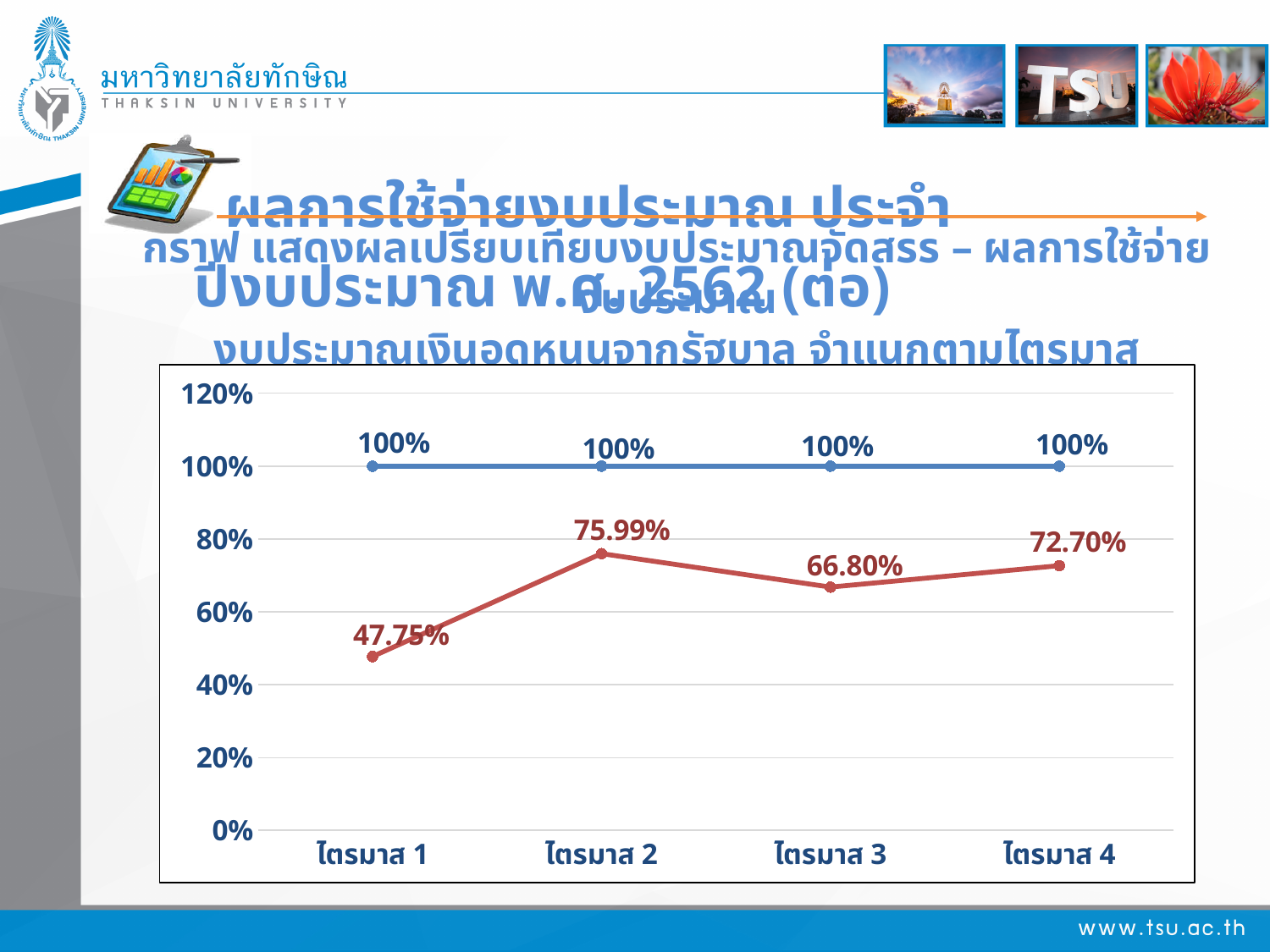
What is the value of the red line for ไตรมาส 3? 66.80% What is the value of the red line for ไตรมาส 2? 75.99% In which quarter is the red line at its highest value? ไตรมาส 2 What is the difference between the red line values for ไตรมาส 2 and ไตรมาส 1? 28.24% Does the red line rise or fall from ไตรมาส 1 to ไตรมาส 2? rise In which quarter is the red line at its lowest value? ไตรมาส 1 What is the value of the red line for ไตรมาส 1? 47.75% What is the value of the blue line for ไตรมาส 3? 100% What type of chart is shown on the slide? line chart Which is larger, the red line value for ไตรมาส 3 or for ไตรมาส 4? ไตรมาส 4 How many quarters (categories) are shown on the x axis of the chart? 4 What is the value of the red line for ไตรมาส 4? 72.70%